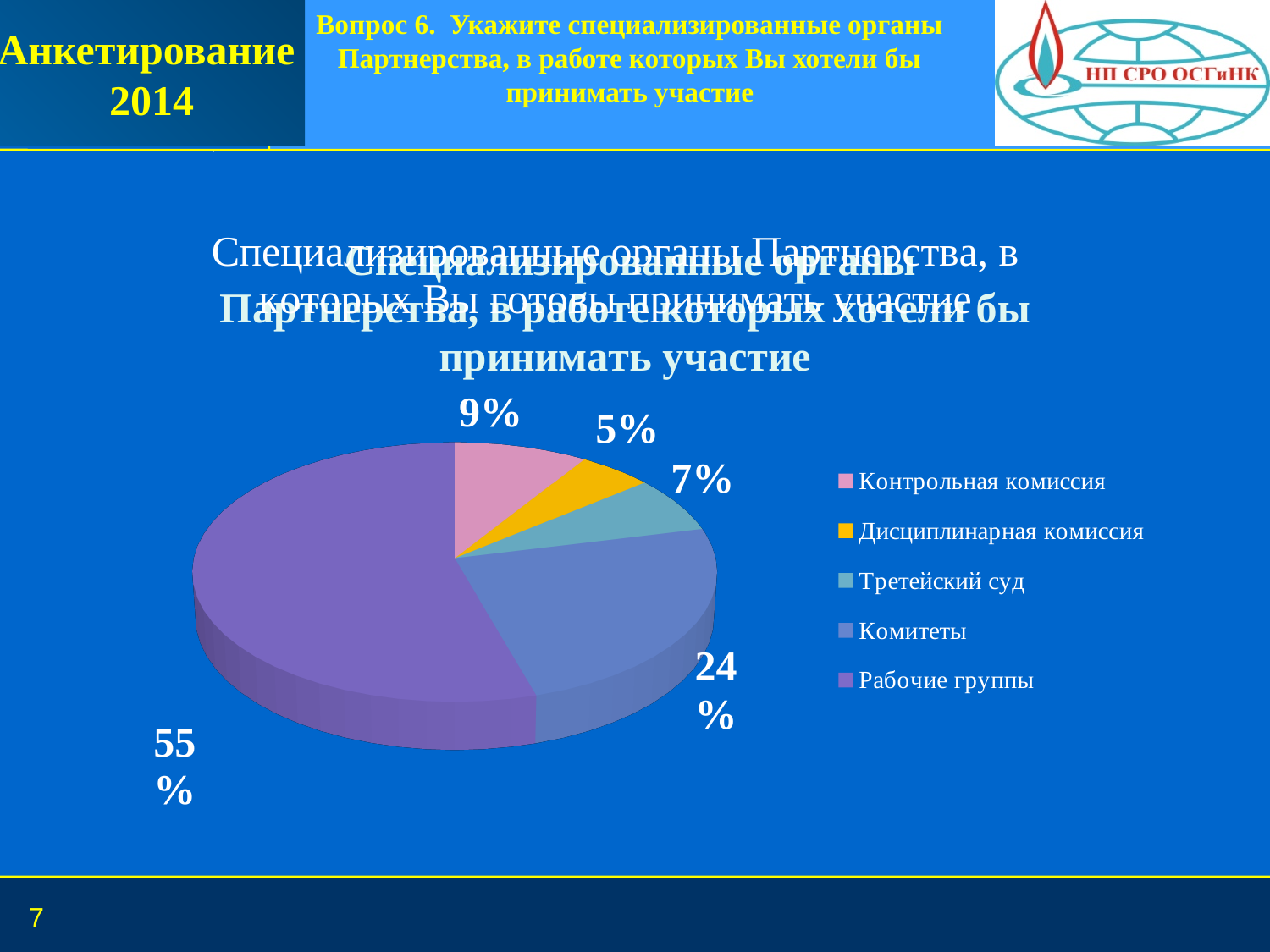
How many categories does the pie chart show? 5 Which category has the largest slice of the pie? Рабочие группы What share of the pie does Рабочие группы have? 55% What share of the pie does Комитеты have? 24% What share of the pie does Дисциплинарная комиссия have? 5% What is the difference in percentage points between Рабочие группы and Комитеты? 31 Which category has the smallest slice of the pie? Дисциплинарная комиссия What kind of chart is shown on the slide? Pie chart What share of the pie does Третейский суд have? 7% What colour is the slice for Дисциплинарная комиссия? Yellow What share of the pie does Контрольная комиссия have? 9% Which is larger, the share for Контрольная комиссия or the share for Третейский суд? Контрольная комиссия